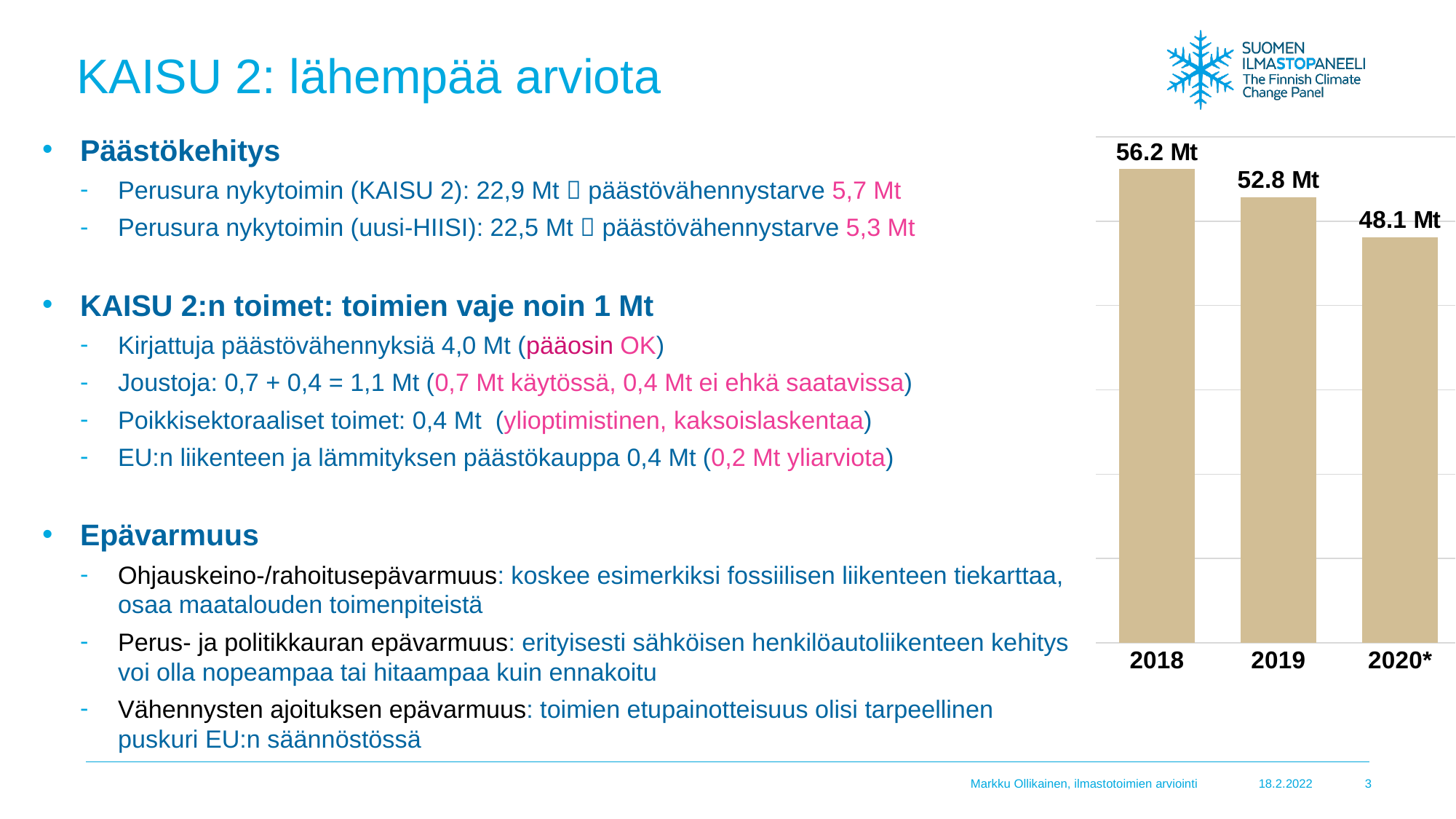
Do the values in the bar chart rise or fall from 2018 to 2020*? Fall What value is shown for 2018 in the bar chart? 56.2 Mt How many bars are in the bar chart? 3 What kind of chart is shown on the slide? Bar chart Which year has the highest value in the bar chart? 2018 What value is shown for 2020* in the bar chart? 48.1 Mt What is the difference between the 2018 and 2020* values in the bar chart? 8.1 Mt Which is larger in the bar chart, the value for 2019 or the value for 2020*? 2019 What is the difference between the 2019 and 2020* values in the bar chart? 4.7 Mt Which year has the lowest value in the bar chart? 2020* What value is shown for 2019 in the bar chart? 52.8 Mt What is the difference between the 2018 and 2019 values in the bar chart? 3.4 Mt